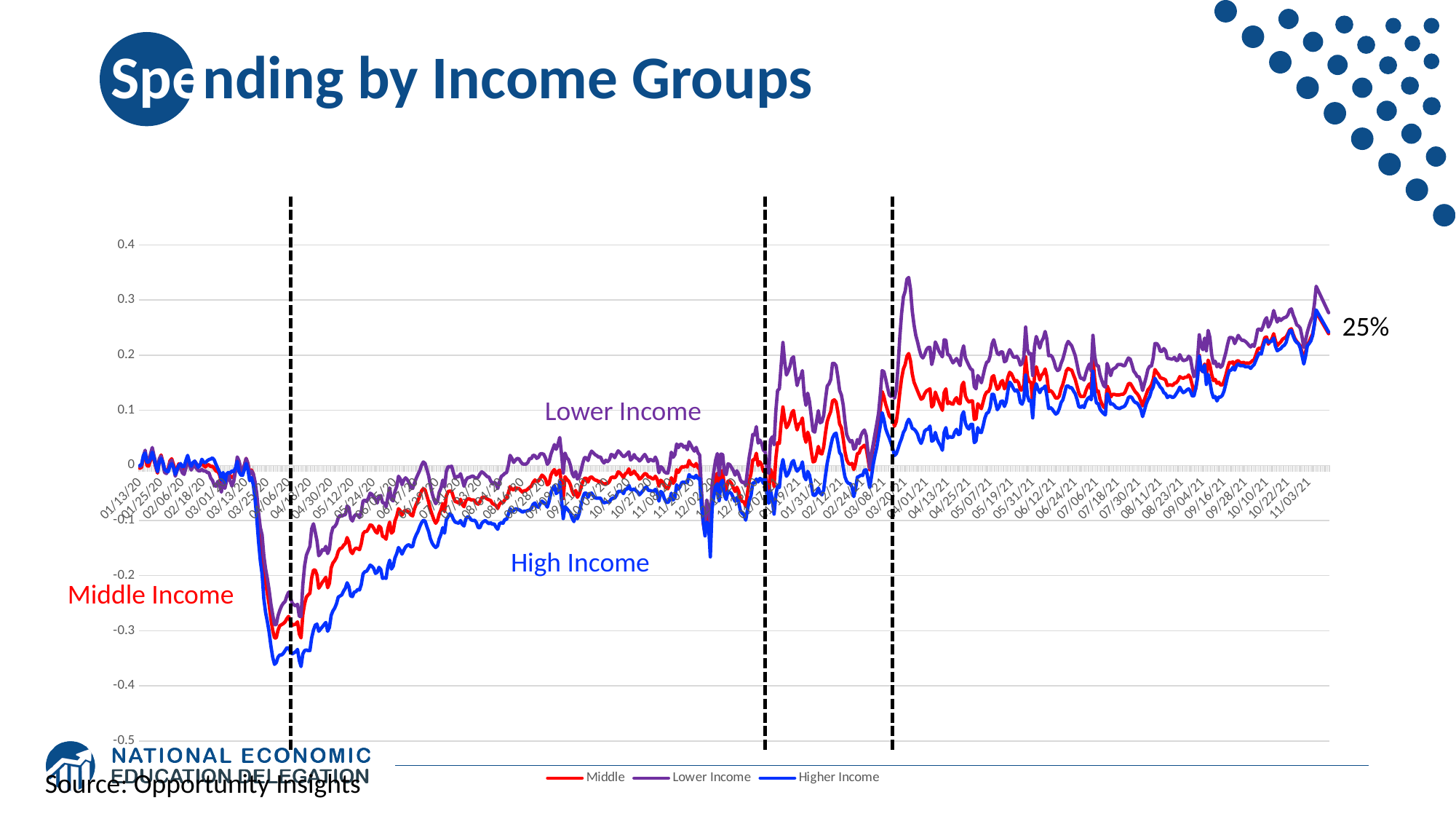
Which income group's line falls to the lowest value on the chart, around 04/06/20? Higher Income How many series does the legend list? 3 Around 04/01/21, which is larger: the Lower Income value or the Higher Income value? Lower Income Is the Higher Income value at the start of the series (01/13/20) greater or less than 0.1? less Do the values for all three income groups generally rise or fall from 04/06/20 to 11/03/21? rise What are the three series listed in the legend? Middle, Lower Income, Higher Income Is the Lower Income value at its peak around 04/01/21 greater or less than 0.3? greater What kind of chart is shown on the slide? Line chart Which income group's line reaches the highest value on the chart, at its peak around 04/01/21? Lower Income What percentage is annotated at the right end of the lines? 25% Is the Middle income value at the end of the series (11/03/21) greater or less than 0.2? greater